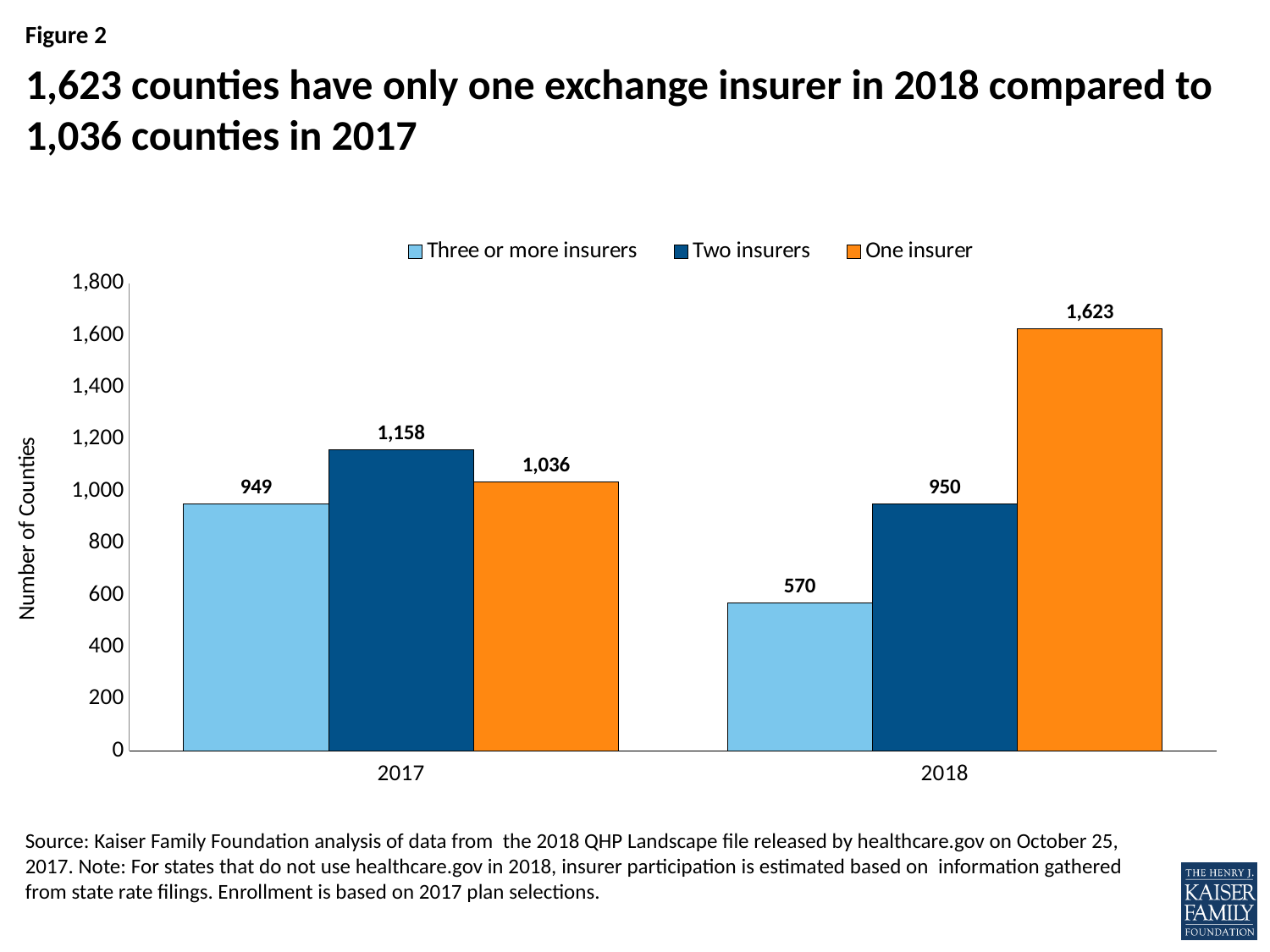
Is the value for three or more insurers in 2018 greater or less than 600? less How many series does the legend list? 3 What kind of chart is shown on the slide? Bar chart Which insurer category had the highest number of counties in 2017? Two insurers Which is larger: the number of counties with two insurers in 2017 or in 2018? 2017 What is the label of the y axis? Number of Counties How many years are shown on the x axis? 2 What is the difference in the number of counties with one insurer between 2018 and 2017? 587 How many counties had three or more insurers in 2017? 949 Which insurer category had the lowest number of counties in 2018? Three or more insurers How many counties had only one insurer in 2018? 1,623 How many counties had two insurers in 2018? 950